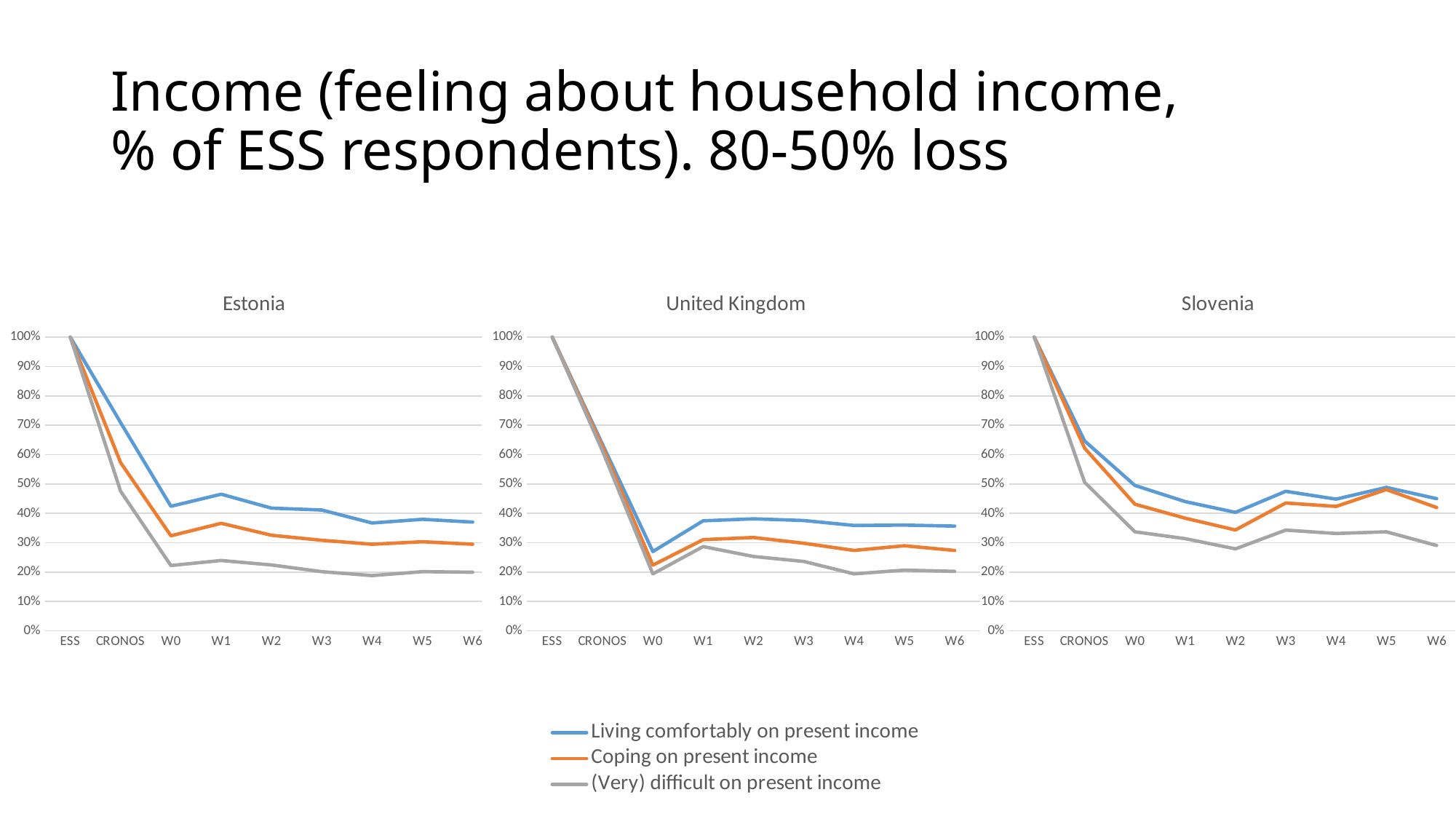
How many series does the legend list? 3 On the Estonia chart, at W6, which is larger: Living comfortably on present income or (Very) difficult on present income? Living comfortably on present income On the United Kingdom chart, is the value for Coping on present income at W0 greater or less than 30%? less On the Slovenia chart, which series has the lowest value at W6? (Very) difficult on present income On the Estonia chart, what is the value for Living comfortably on present income at ESS? 100% How many points are on the x axis of the Slovenia chart? 9 On the Estonia chart, is the value for (Very) difficult on present income at W4 greater or less than 20%? less What kind of chart is the United Kingdom chart? line chart On the United Kingdom chart, what is the value for (Very) difficult on present income at ESS? 100% On the Estonia chart, is the value for Living comfortably on present income at W1 greater or less than 40%? greater On the United Kingdom chart, which series has the highest value at W6? Living comfortably on present income